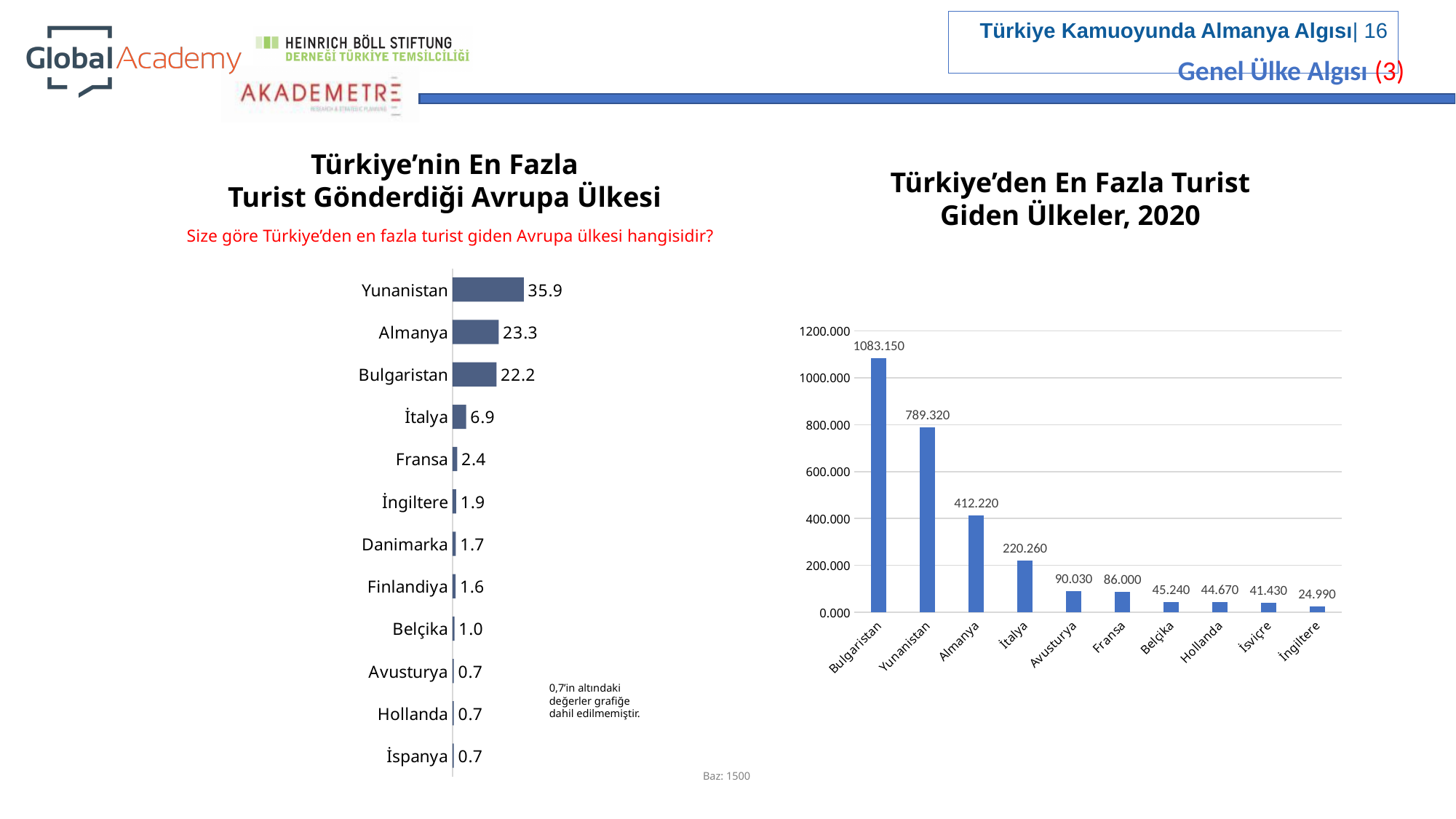
In the right chart 'Türkiye'den En Fazla Turist Giden Ülkeler, 2020', how many countries are shown? 10 In the right chart 'Türkiye'den En Fazla Turist Giden Ülkeler, 2020', which country has the lowest value? İngiltere In the right chart 'Türkiye'den En Fazla Turist Giden Ülkeler, 2020', what is the value for Bulgaristan? 1083.150 What kind of chart is the left chart 'Türkiye'nin En Fazla Turist Gönderdiği Avrupa Ülkesi'? Bar chart In the right chart 'Türkiye'den En Fazla Turist Giden Ülkeler, 2020', which is larger, the value for Avusturya or the value for Fransa? Avusturya In the right chart 'Türkiye'den En Fazla Turist Giden Ülkeler, 2020', do the values rise or fall from left to right along the x axis? Fall In the left chart 'Türkiye'nin En Fazla Turist Gönderdiği Avrupa Ülkesi', which country has the highest value? Yunanistan In the right chart 'Türkiye'den En Fazla Turist Giden Ülkeler, 2020', what is the value for Almanya? 412.220 In the left chart 'Türkiye'nin En Fazla Turist Gönderdiği Avrupa Ülkesi', what is the difference between the values for Yunanistan and Bulgaristan? 13.7 In the left chart 'Türkiye'nin En Fazla Turist Gönderdiği Avrupa Ülkesi', how many countries are listed? 12 In the left chart 'Türkiye'nin En Fazla Turist Gönderdiği Avrupa Ülkesi', what is the value for Fransa? 2.4 In the left chart 'Türkiye'nin En Fazla Turist Gönderdiği Avrupa Ülkesi', what is the value for Almanya? 23.3